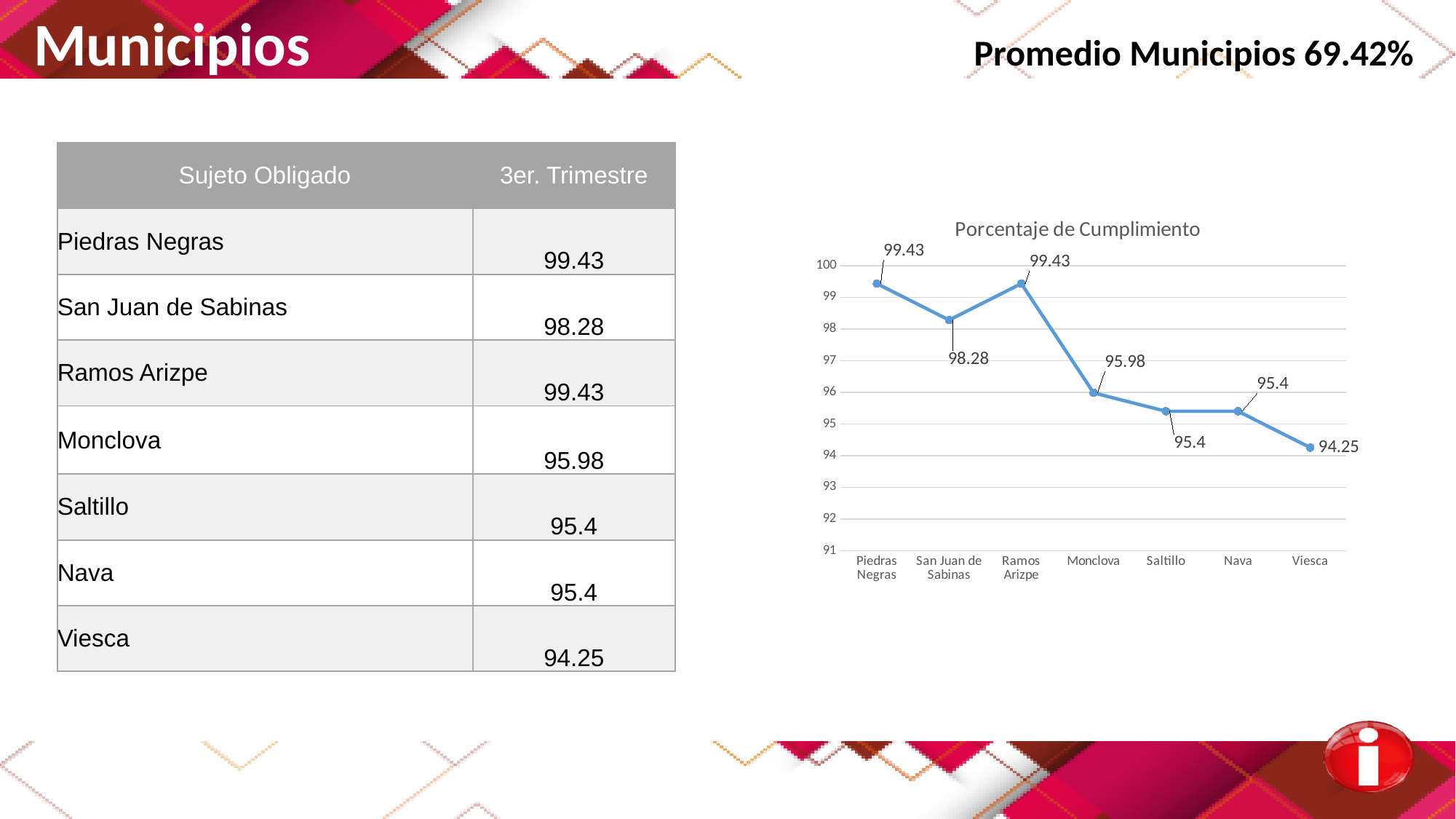
What type of chart is shown on the slide? line chart What is the value for San Juan de Sabinas in the chart? 98.28 Which municipality has the lowest value in the chart? Viesca What is the value for Viesca in the chart? 94.25 What is the difference between the values for Ramos Arizpe and Monclova? 3.45 How many municipalities are plotted in the chart? 7 What is the value for Monclova in the chart? 95.98 Is the value for Nava greater or less than 96? less Which is larger, the value for Monclova or the value for Saltillo? Monclova What is the title of the chart? Porcentaje de Cumplimiento What is the difference between the values for Piedras Negras and Viesca? 5.18 Do the values generally rise or fall from Piedras Negras to Viesca along the x axis? fall